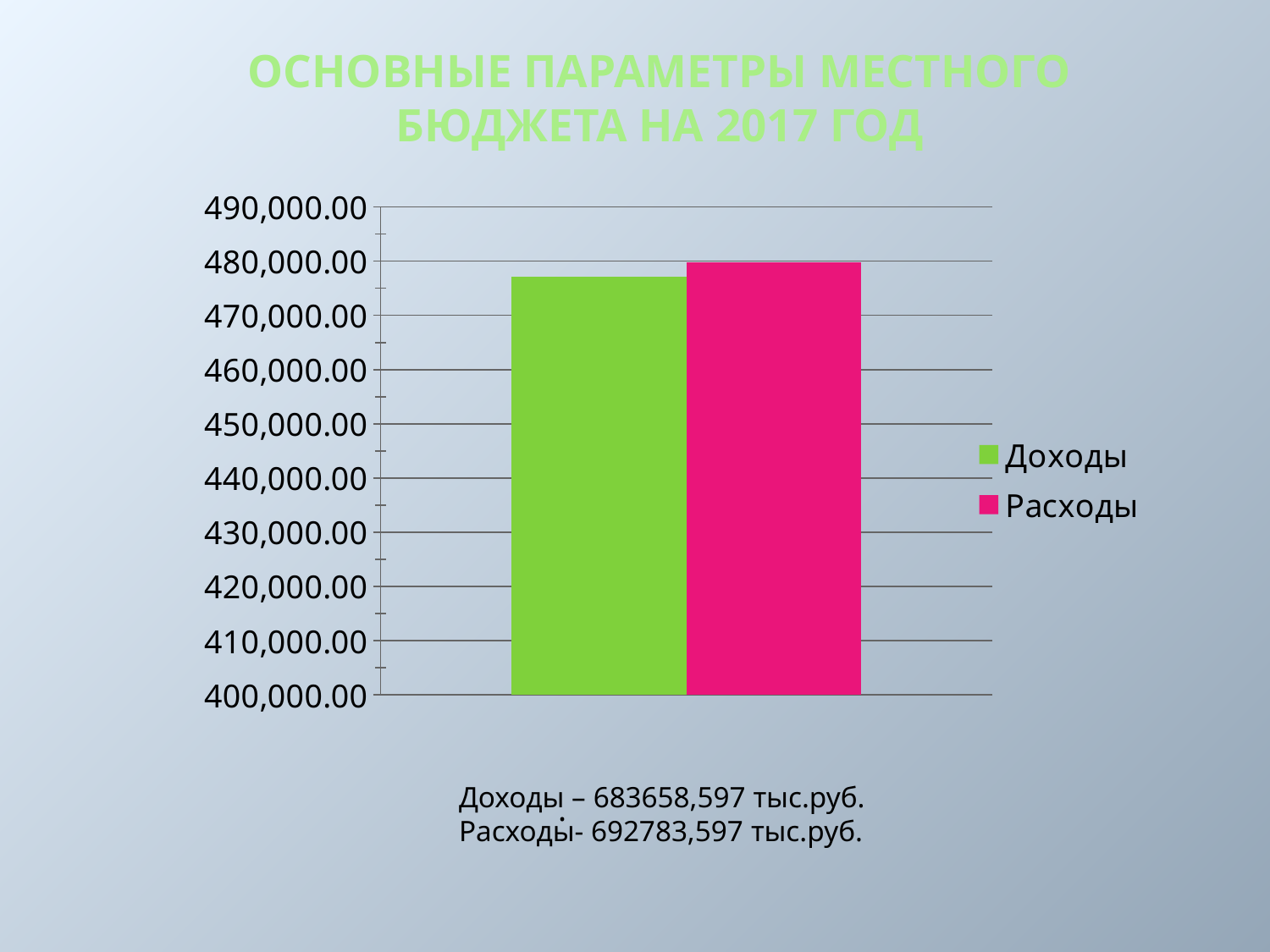
Which series has the lowest value? Доходы Is the value for Доходы greater or less than 470,000.00? greater How many bars are plotted in the chart? 2 Is the value for Доходы greater or less than 480,000.00? less What is the title of the slide containing the chart? ОСНОВНЫЕ ПАРАМЕТРЫ МЕСТНОГО БЮДЖЕТА НА 2017 ГОД Is the value for Расходы greater or less than 490,000.00? less What kind of chart is shown on the slide? bar chart Which series has the highest value? Расходы Which series has the taller bar, Доходы or Расходы? Расходы What colour is the bar for Расходы? pink How many series does the legend list? 2